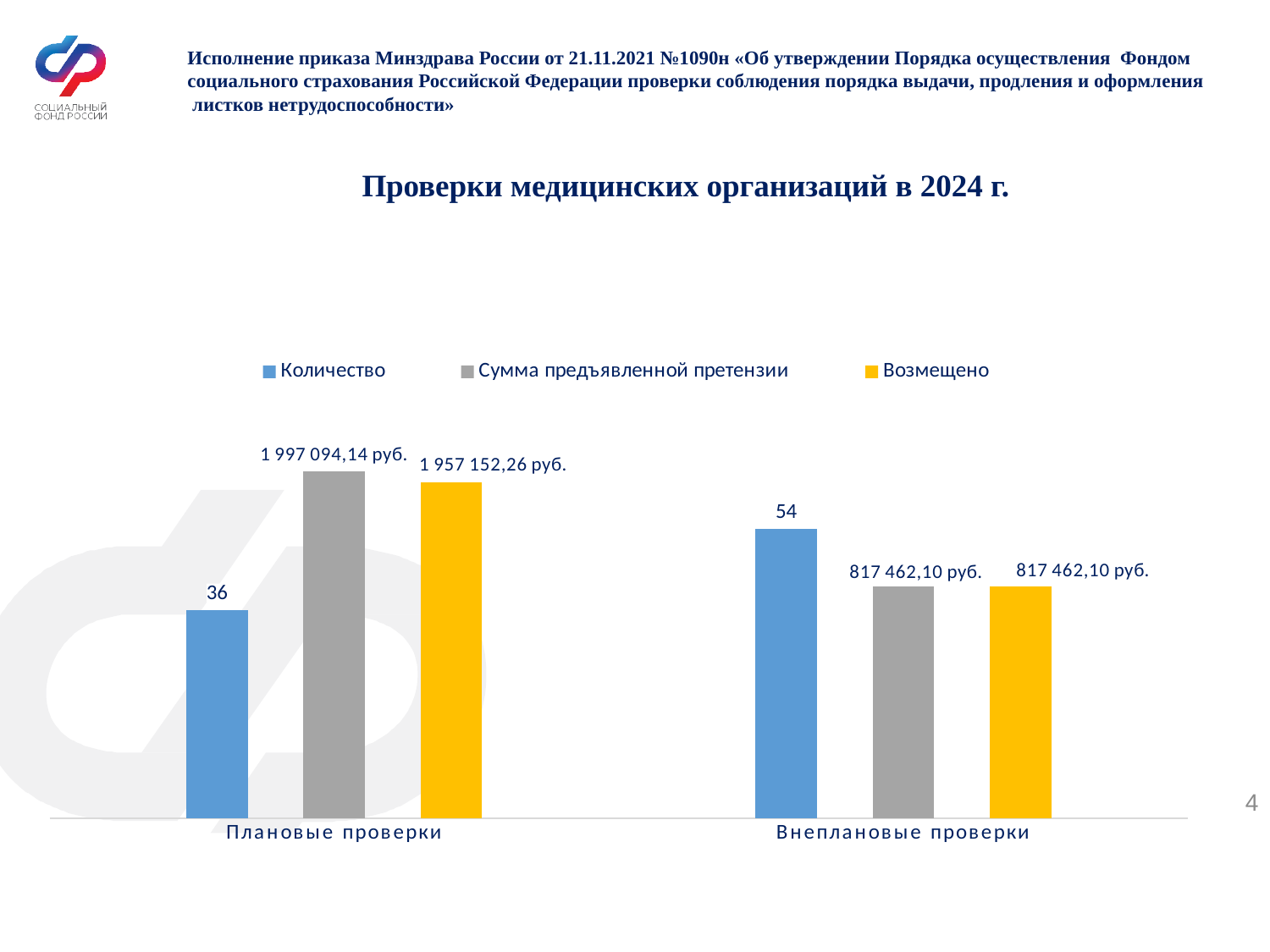
What is the value of Количество for Внеплановые проверки? 54 What type of chart is shown on the slide? Bar chart What is the value of Возмещено for Плановые проверки? 1 957 152,26 руб. What is the value of Сумма предъявленной претензии for Плановые проверки? 1 997 094,14 руб. Which category has the higher value of Количество? Внеплановые проверки What is the value of Возмещено for Внеплановые проверки? 817 462,10 руб. How many series does the legend list? 3 What is the difference between the Количество values for Внеплановые проверки and Плановые проверки? 18 How many categories are shown on the x axis? 2 What is the difference between Сумма предъявленной претензии and Возмещено for Плановые проверки? 39 941,88 руб. What is the value of Количество for Плановые проверки? 36 What is the title of the chart? Проверки медицинских организаций в 2024 г.